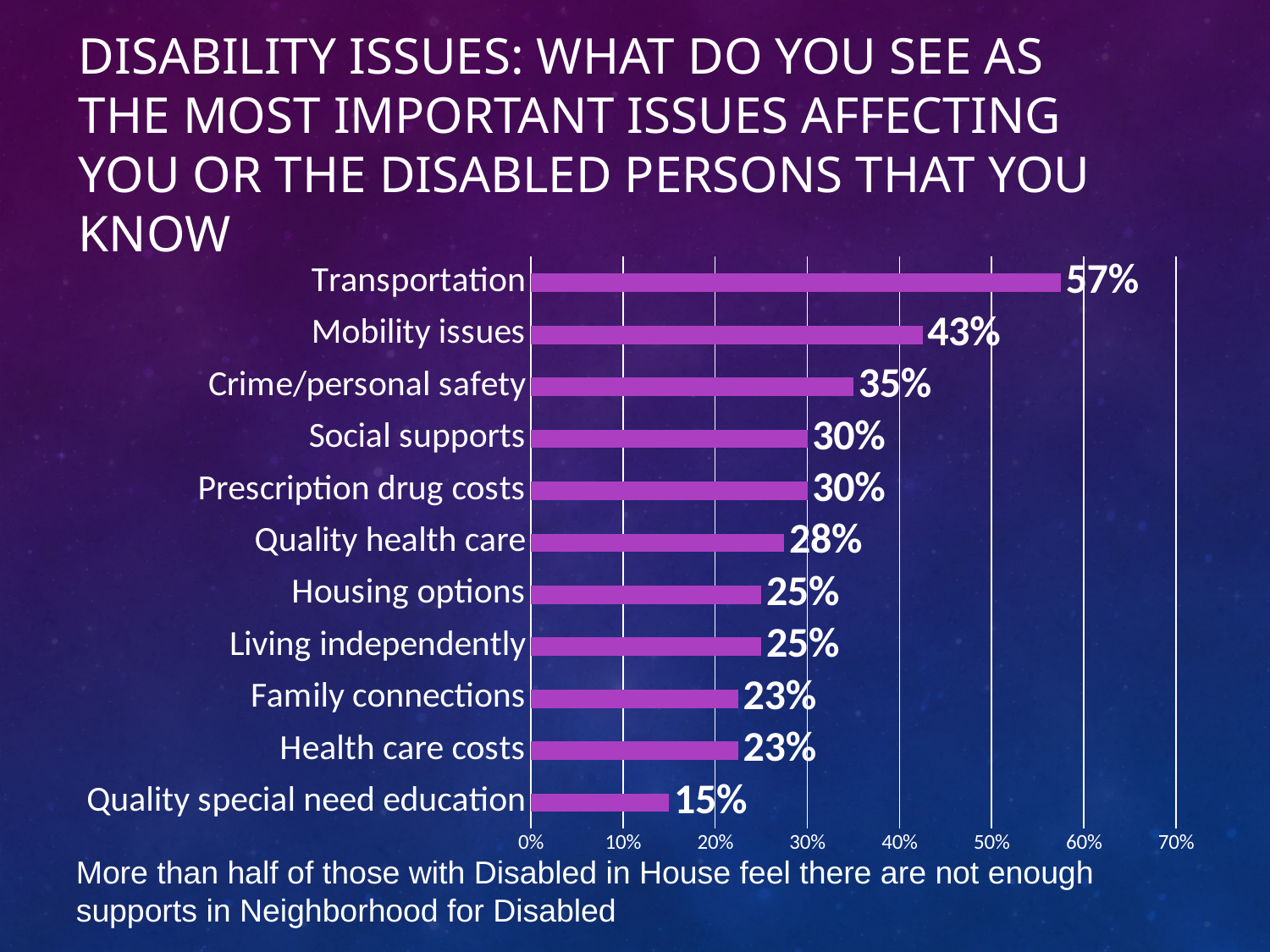
What kind of chart is shown on the slide? Bar chart Which issue has the lowest percentage? Quality special need education How many issues are listed in the chart? 11 Which is larger, the value for Crime/personal safety or the value for Social supports? Crime/personal safety What is the difference between the values for Quality health care and Housing options? 3% What is the value shown for Crime/personal safety? 35% What is the value shown for Quality special need education? 15% What percentage of respondents cited Transportation as a most important issue? 57% What is the difference between the values for Transportation and Mobility issues? 14% What is the highest value shown on the x axis? 70% Which issue has the highest percentage? Transportation What is the value shown for Mobility issues? 43%